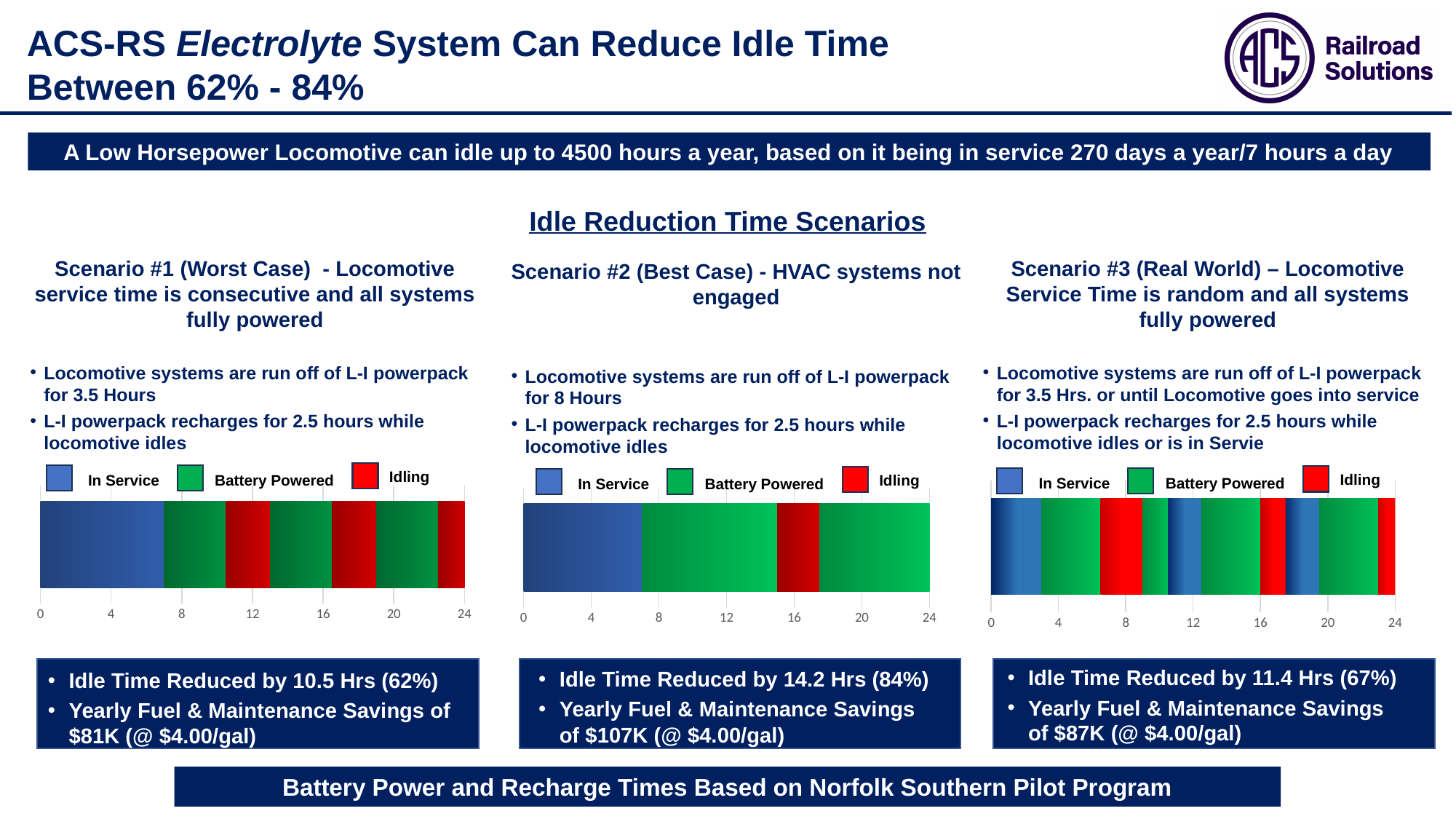
In the Scenario #3 (Real World) chart, what colour represents Idling? red In the Scenario #2 (Best Case) chart, does the first Battery Powered segment end at a value greater or less than 16? less In the Scenario #2 (Best Case) chart, does the In Service segment end at a value greater or less than 8? less In the Scenario #1 (Worst Case) chart, how many Idling segments appear in the bar? 3 In the Scenario #2 (Best Case) chart, which is longer: the In Service segment or the Idling segment? In Service In the Scenario #2 (Best Case) chart, how many Idling segments appear in the bar? 1 What kind of chart is used for Scenario #1 (Worst Case)? bar chart What are the three legend entries on the Scenario #1 (Worst Case) chart? In Service, Battery Powered, Idling In the Scenario #2 (Best Case) chart, how many segments make up the bar in total? 4 In the Scenario #1 (Worst Case) chart, which series occupies the longest single segment of the bar? In Service What is the maximum value shown on the x axis of the Scenario #2 (Best Case) chart? 24 How many series does the legend list for the Scenario #2 (Best Case) chart? 3